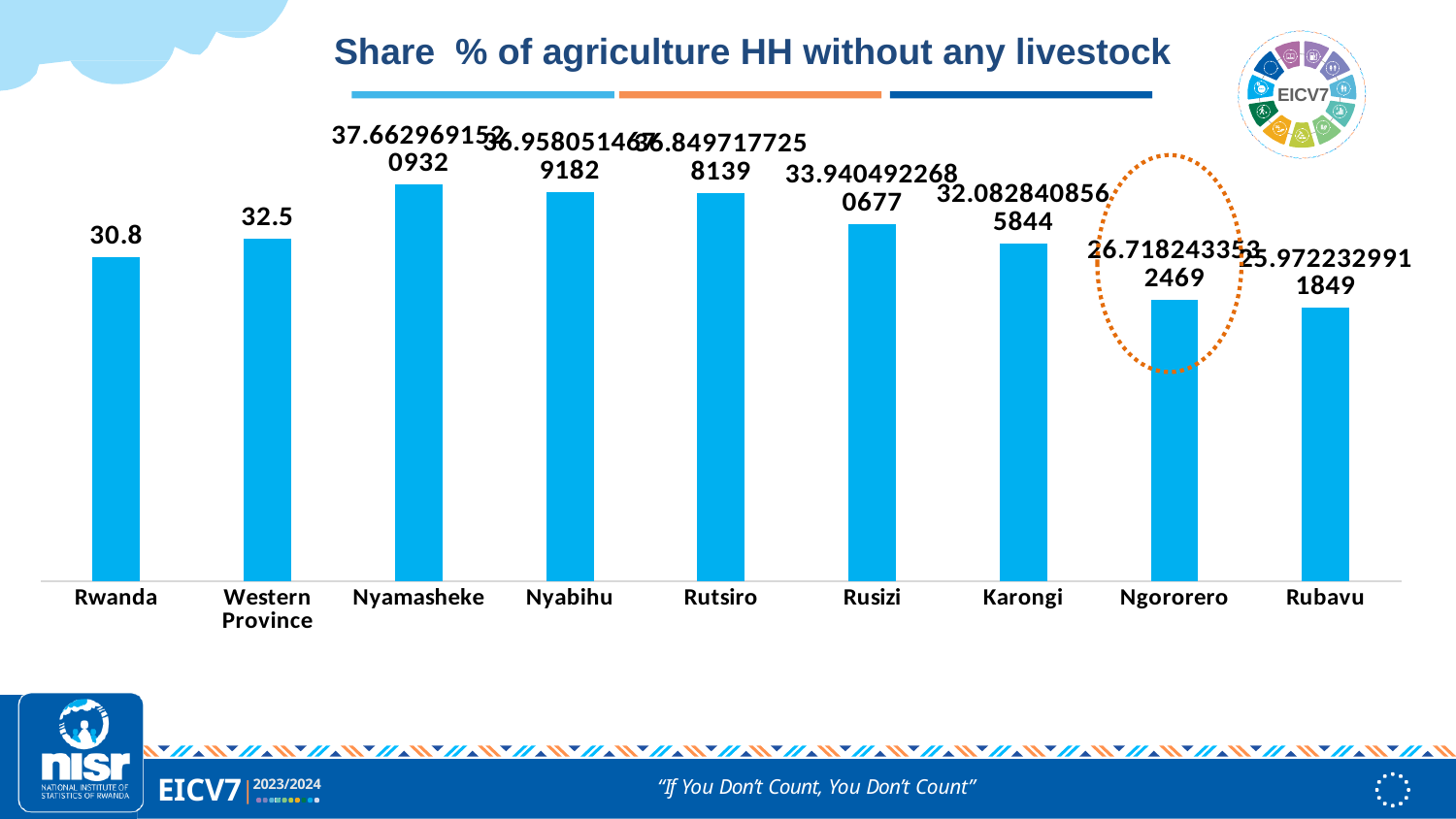
What is the difference between the values for Western Province and Rwanda? 1.7 Which category has the lowest share of agriculture households without any livestock? Rubavu Do the values rise or fall from Nyamasheke to Rubavu along the x axis? Fall How many categories are shown on the x axis? 9 Which is larger, the value for Rusizi or the value for Karongi? Rusizi What is the value for Western Province? 32.5 What is the title of the chart? Share % of agriculture HH without any livestock Which category's bar is highlighted with a dashed orange circle? Ngororero What is the value for Rwanda? 30.8 Which category has the highest share of agriculture households without any livestock? Nyamasheke What kind of chart is shown on the slide? Bar chart Which is larger, the value for Rwanda or the value for Nyamasheke? Nyamasheke